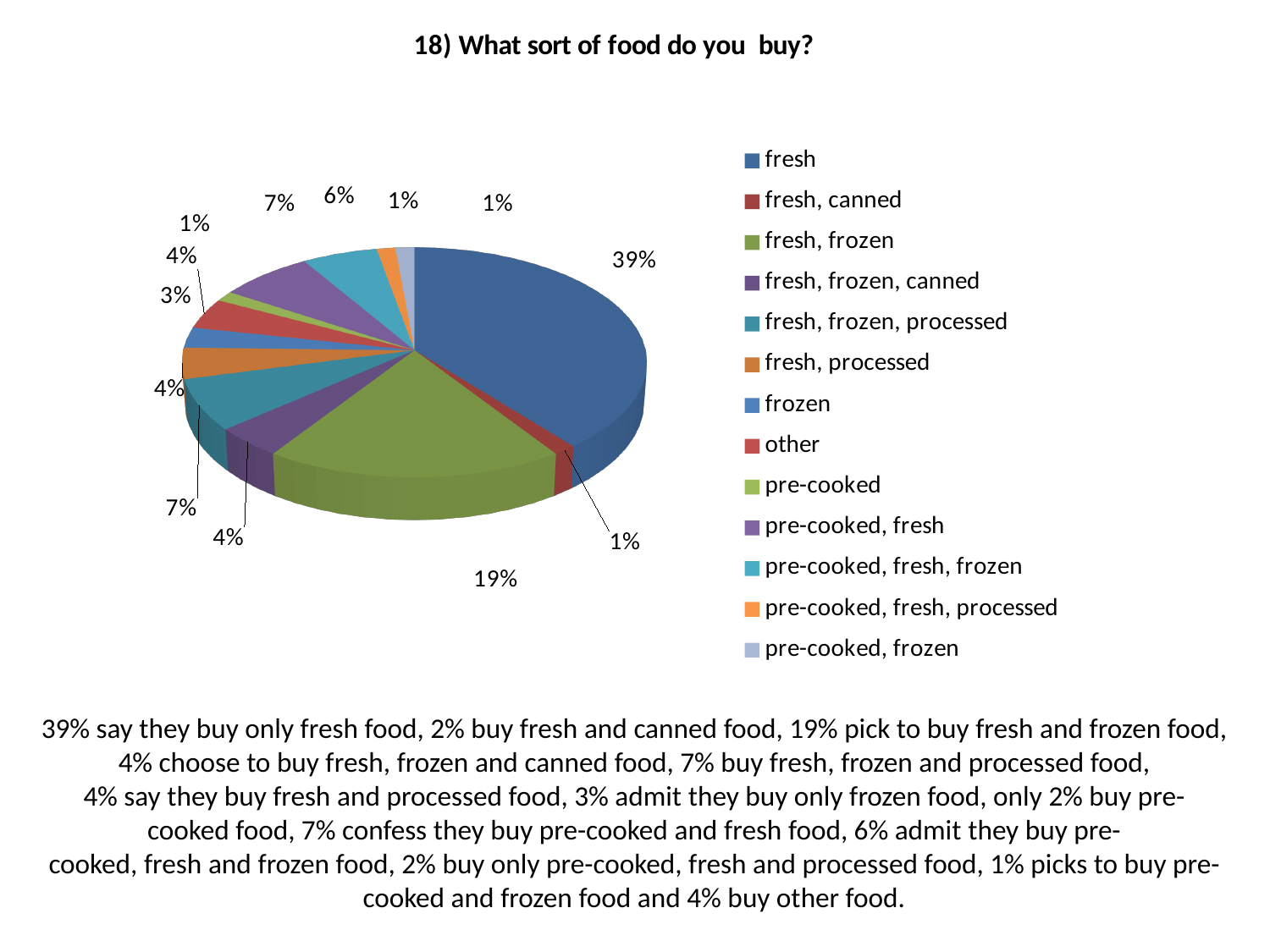
What is the title of the chart? 18) What sort of food do you buy? What colour is the slice for 'fresh, frozen'? green How many categories does the legend list? 13 What kind of chart is shown on the slide? pie chart What share of the pie is labelled for 'fresh'? 39% What share of the pie is labelled for 'fresh, frozen'? 19% What share of the pie is labelled for 'pre-cooked, fresh, frozen'? 6% Which category has the largest slice of the pie? fresh What is the difference in percentage points between the 'fresh' slice and the 'fresh, frozen' slice? 20 Which is larger, the slice for 'fresh' or the slice for 'fresh, frozen'? fresh